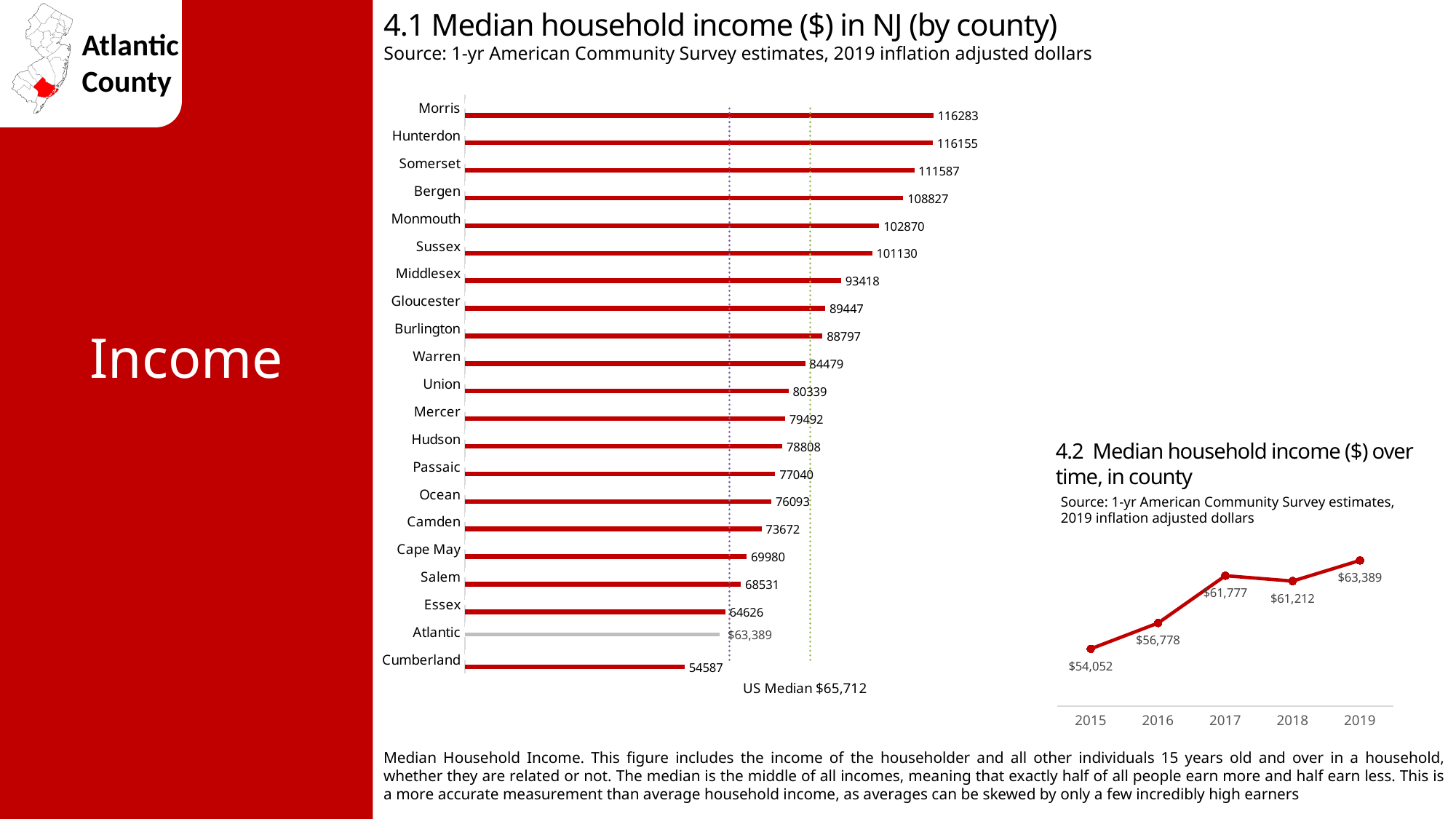
In chart 4.2 (Median household income over time, in county), what is the value for 2017? $61,777 In chart 4.1 (Median household income in NJ by county), which county has the lowest median household income? Cumberland In chart 4.1 (Median household income in NJ by county), how many counties are plotted? 21 In chart 4.1 (Median household income in NJ by county), what is the median household income for Bergen? 108827 What kind of chart is chart 4.1 (Median household income in NJ by county)? Bar chart In chart 4.2 (Median household income over time, in county), which year has the highest value? 2019 In chart 4.1 (Median household income in NJ by county), which has a higher median household income, Camden or Cape May? Camden In chart 4.1 (Median household income in NJ by county), which county has the highest median household income? Morris In chart 4.1 (Median household income in NJ by county), what is the difference between the values for Morris and Cumberland? 61696 In chart 4.1 (Median household income in NJ by county), what is the value shown for Atlantic? $63,389 In chart 4.2 (Median household income over time, in county), which is larger, the value for 2017 or 2018? 2017 In chart 4.2 (Median household income over time, in county), what is the difference between the 2019 and 2015 values? $9,337